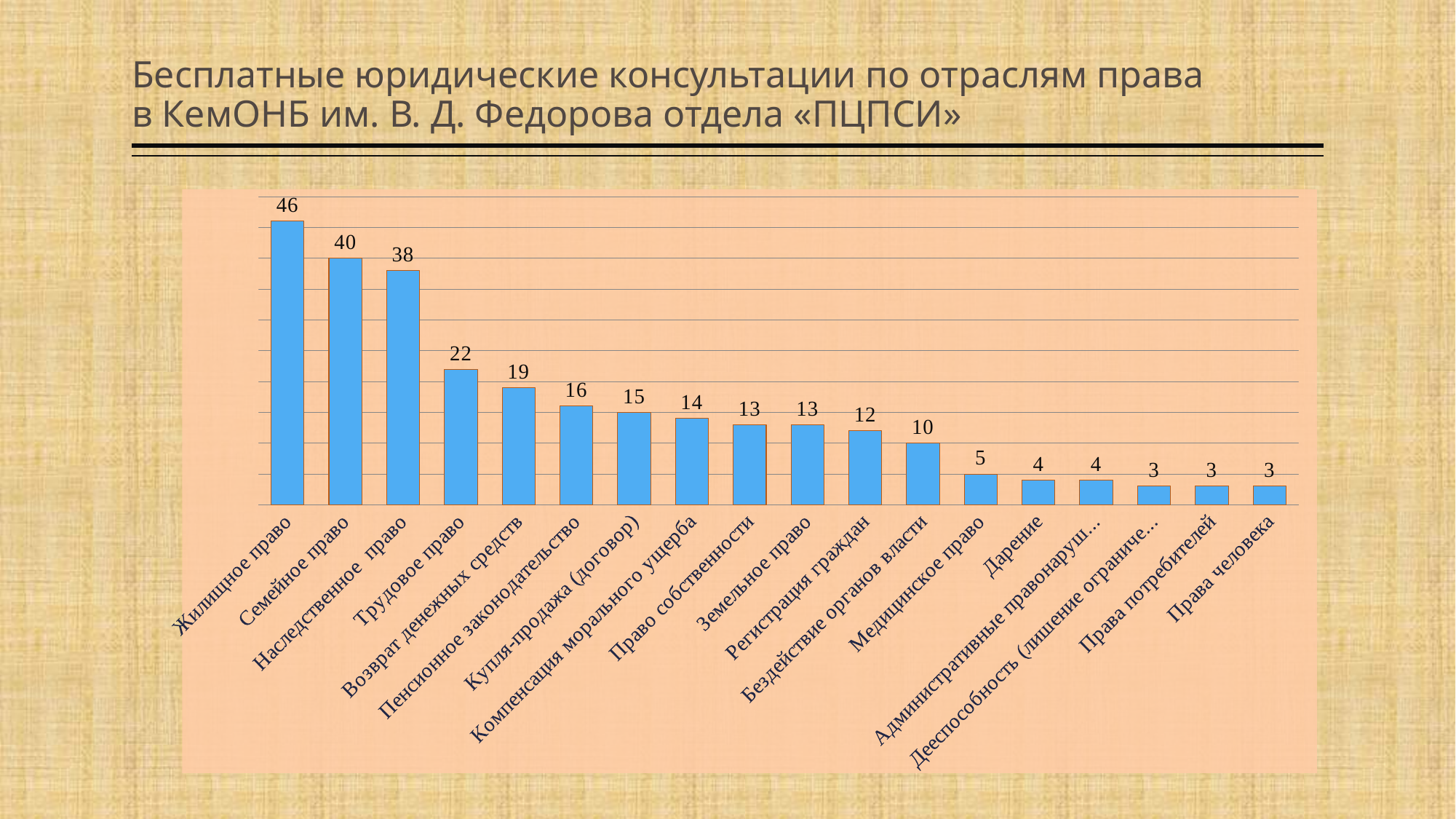
What is the value for Бездействие органов власти? 10 Which category has the highest value? Жилищное право Which is larger, the value for Возврат денежных средств or the value for Пенсионное законодательство? Возврат денежных средств Do the values rise or fall moving from left to right along the x axis? fall What is the value for Трудовое право? 22 What is the lowest value shown in the chart? 3 What is the value for Семейное право? 40 How many categories are plotted in the chart? 18 What is the value for Жилищное право? 46 What type of chart is shown on the slide? bar chart What is the value for Медицинское право? 5 What is the difference between the values for Жилищное право and Наследственное право? 8